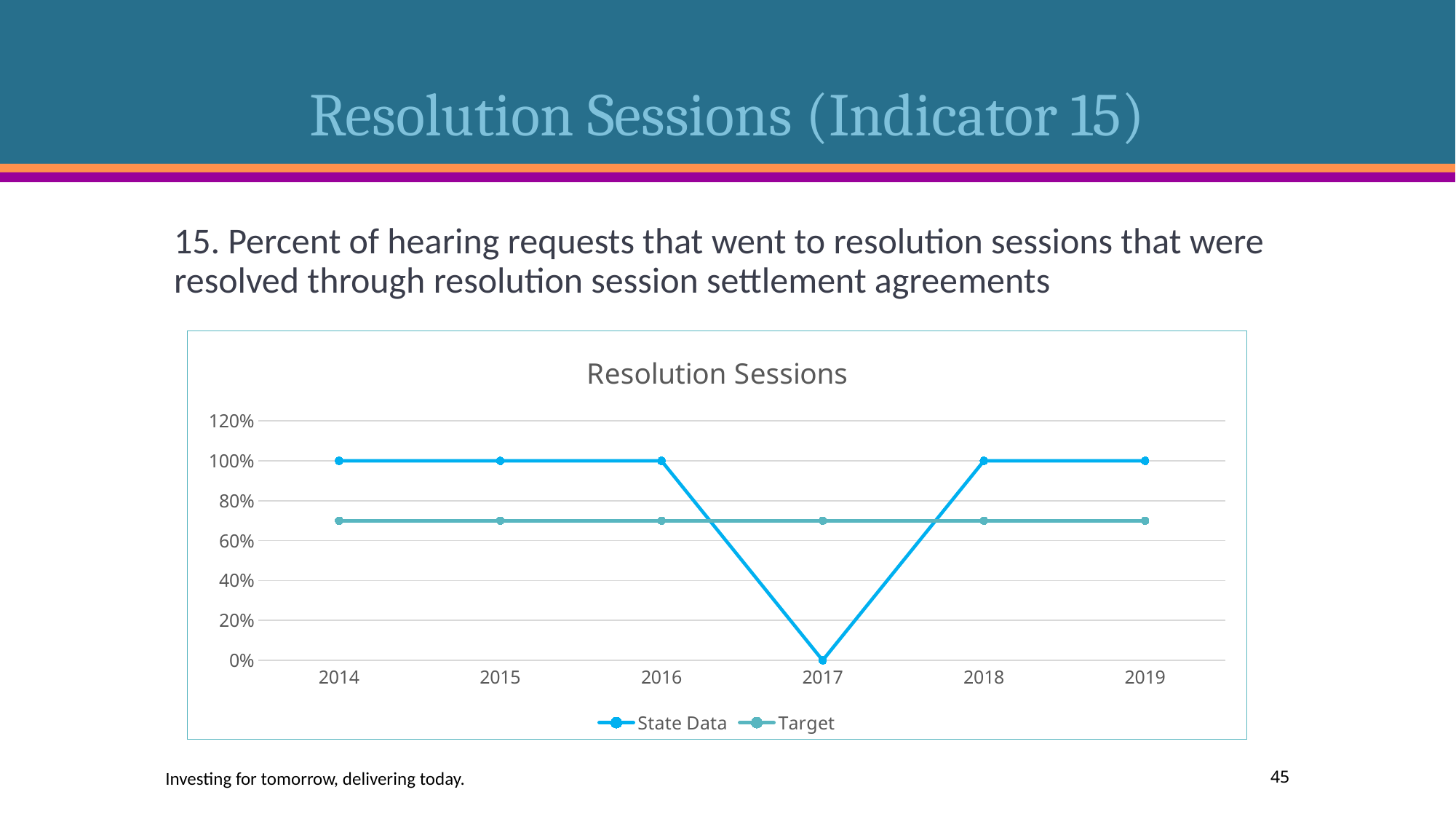
How many years are plotted along the x axis of the chart? 6 Is the Target value for 2015 greater or less than 80%? less What is the difference between the State Data values for 2016 and 2017? 100% Which is larger in 2016, the State Data value or the Target value? State Data What is the State Data value for 2019? 100% In which year is the State Data value lowest? 2017 What is the State Data value for 2017? 0% What kind of chart is shown on the slide? line chart What is the State Data value for 2014? 100% What is the title of the chart? Resolution Sessions How many series does the chart legend list? 2 Is the Target value for 2018 greater or less than 60%? greater